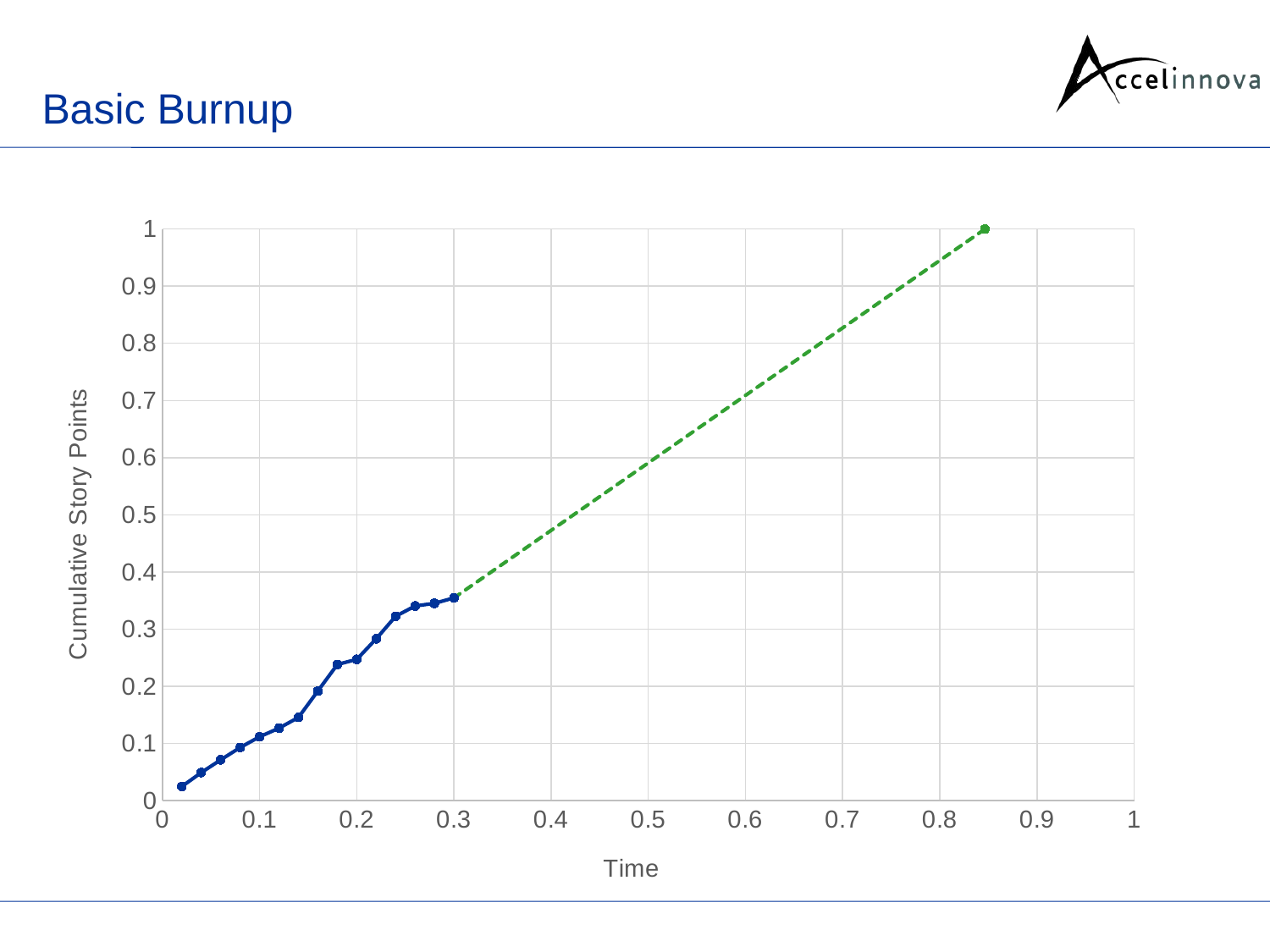
Is the value of the blue line at Time 0.3 greater or less than 0.3? greater Which is larger: the value of the blue line at Time 0.2 or at Time 0.1? Time 0.2 What is the label of the vertical axis? Cumulative Story Points Do the values of the blue line rise or fall as Time increases? rise What kind of chart is shown on the slide? line chart Is the value of the green dashed line at Time 0.6 greater or less than 0.6? greater Is the value of the blue line at Time 0.3 greater or less than 0.4? less At which Time value does the blue line reach its highest point? 0.3 What is the title of the chart on the slide? Basic Burnup What Cumulative Story Points value does the green dashed line reach at its end point? 1